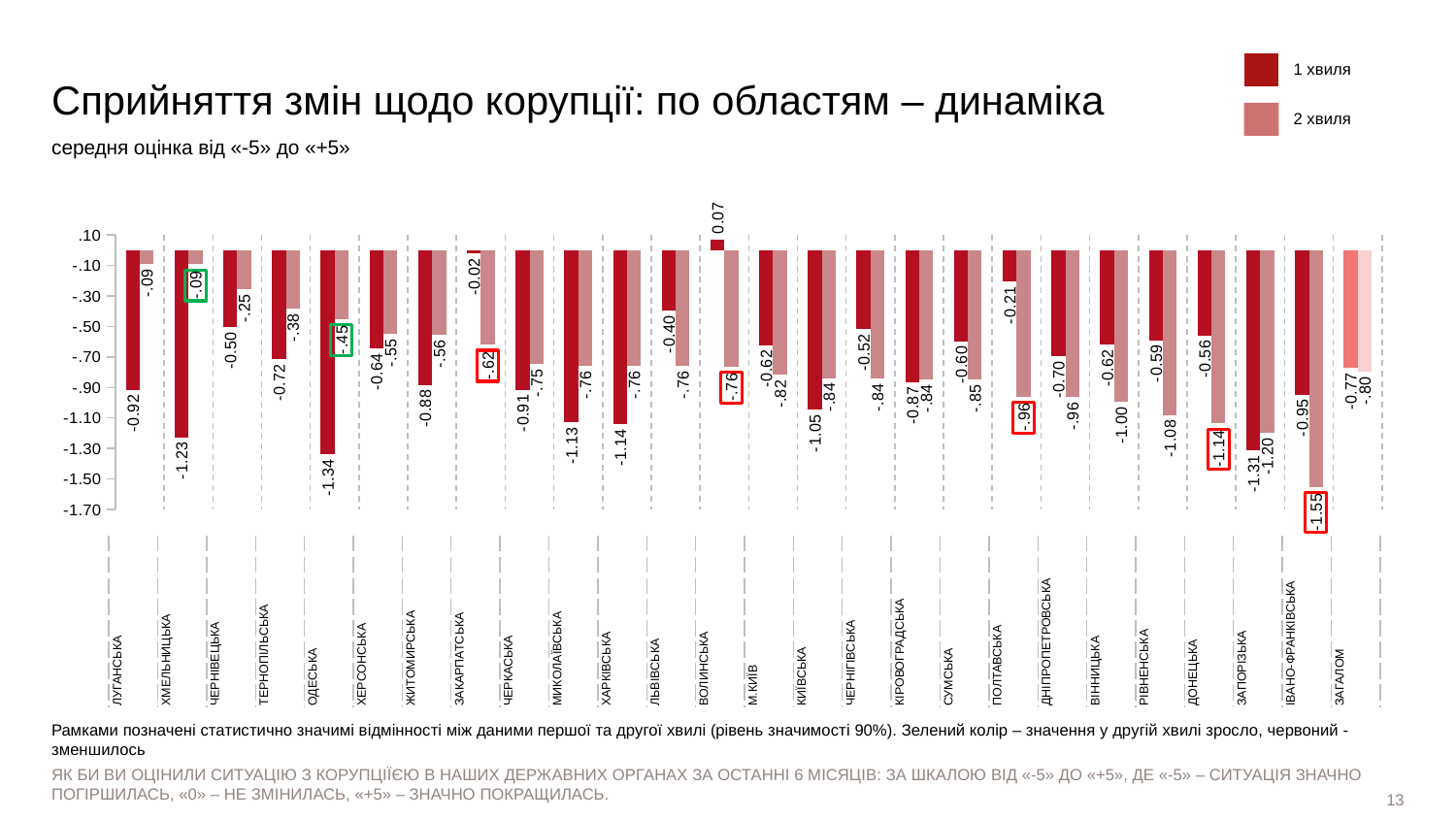
Which category has the lowest value in the 1 хвиля series? Одеська What is the value for Загалом in the 2 хвиля series? -.80 What are the two series named in the legend? 1 хвиля and 2 хвиля How many series does the legend list? 2 For Закарпатська, which is larger: the 1 хвиля value or the 2 хвиля value? 1 хвиля What is the value for Волинська in the 1 хвиля series? 0.07 What is the value for Луганська in the 1 хвиля series? -0.92 What kind of chart is shown on the slide? bar chart How many categories (regions, including Загалом) are shown on the x axis? 26 Which category has the lowest value in the 2 хвиля series? Івано-Франківська Which category has the highest value in the 1 хвиля series? Волинська What is the difference between the 1 хвиля and 2 хвиля values for Хмельницька? 1.14